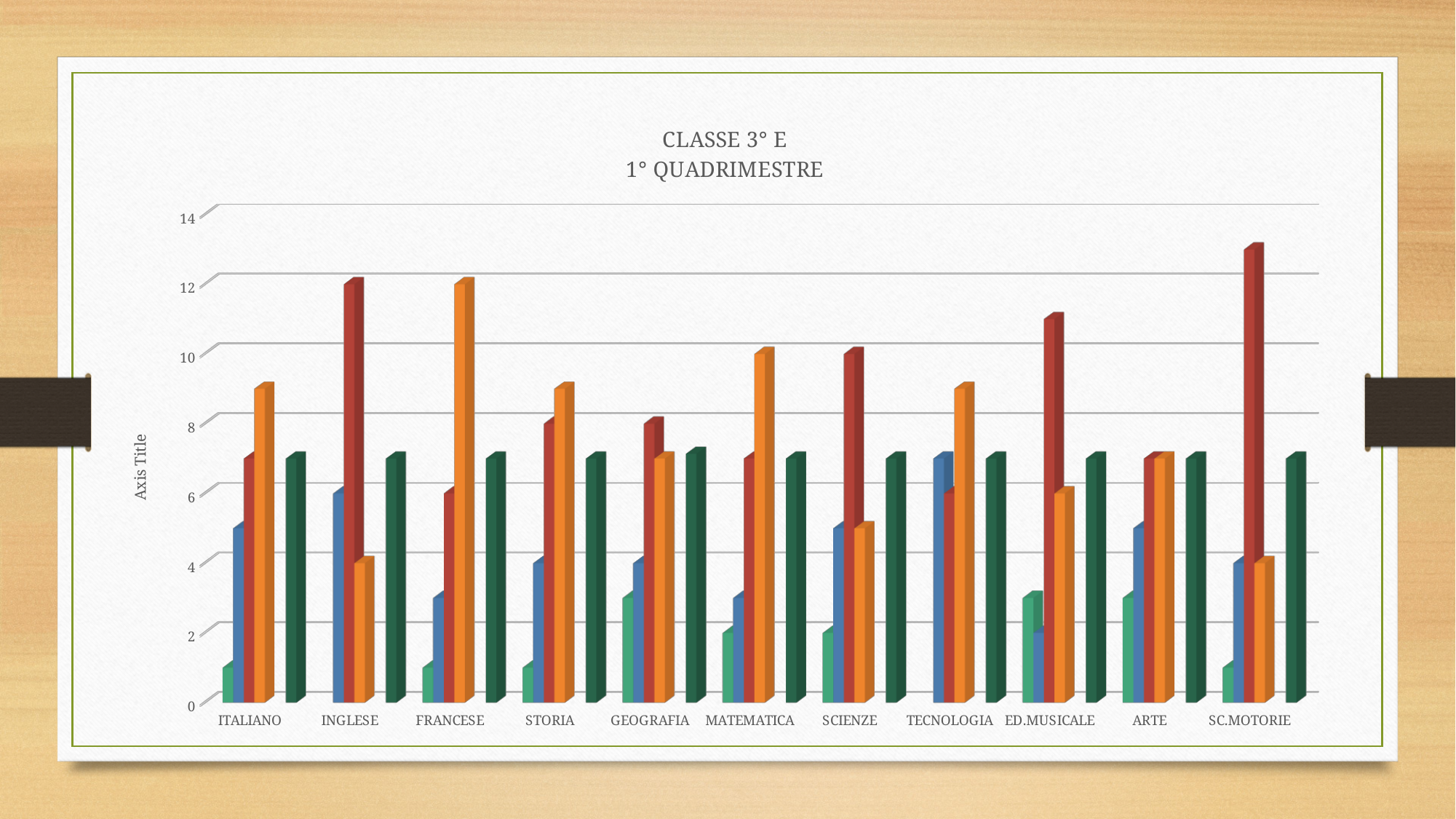
What is the label on the vertical axis? Axis Title What is the value of the orange bar for FRANCESE? 12 What kind of chart is shown on the slide? bar chart What is the value of the red bar for INGLESE? 12 What is the difference between the red bar and the orange bar for INGLESE? 8 For which subject is the red bar the highest? SC.MOTORIE Is the value of the red bar for SC.MOTORIE greater or less than 12? greater For INGLESE, which is larger, the red bar or the orange bar? red bar For which subject is the orange bar the highest? FRANCESE What is the title of the chart? CLASSE 3° E 1° QUADRIMESTRE What is the value of the orange bar for MATEMATICA? 10 How many subject categories are shown on the x axis? 11